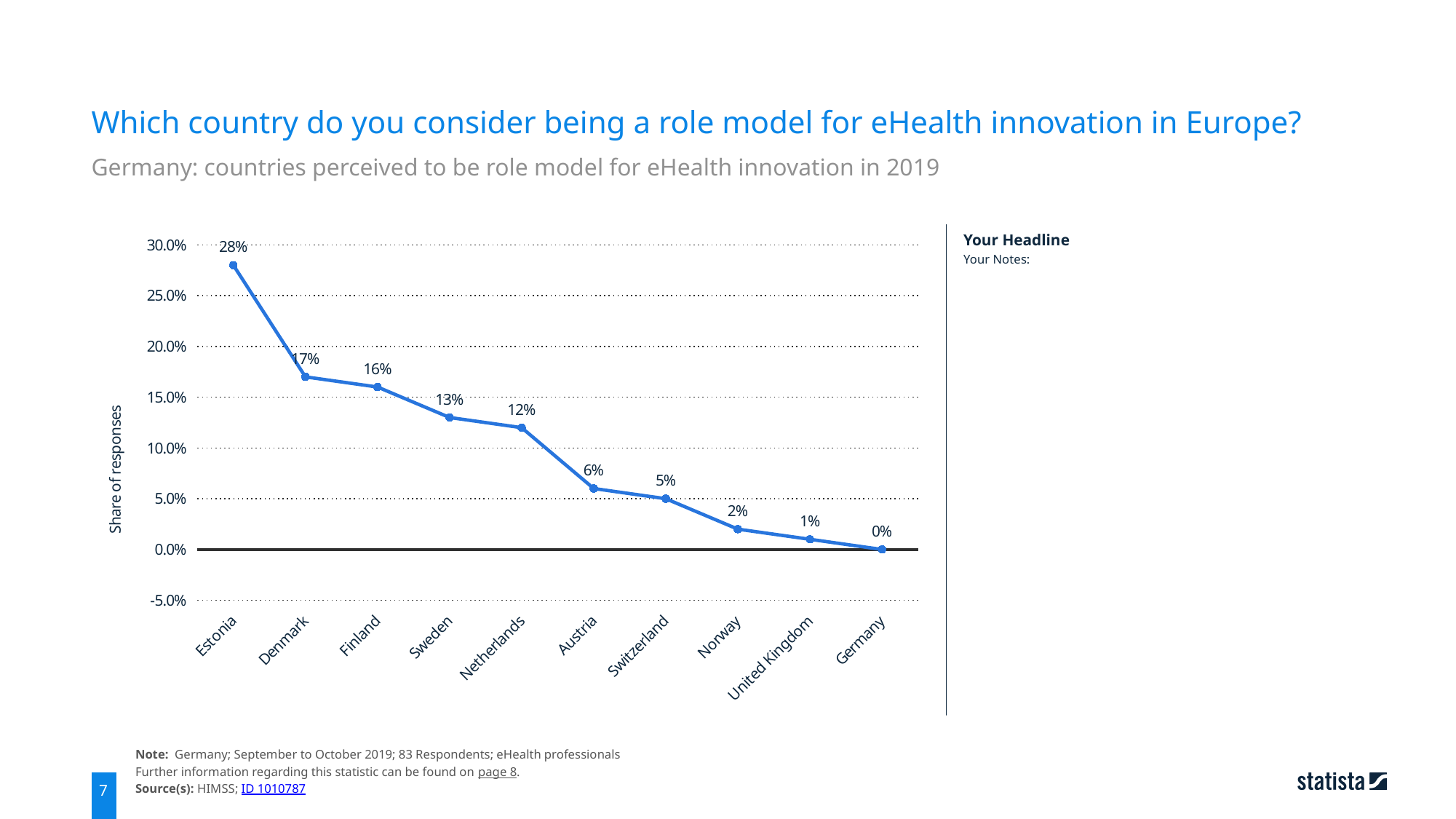
Which country has the lowest share of responses? Germany Which country has the highest share of responses? Estonia What is the difference between the values for Estonia and Denmark? 11% What kind of chart is shown on the slide? line chart What is the difference between the values for Netherlands and Austria? 6% How many countries are plotted on the chart? 10 Is the value for Denmark greater or less than 20.0%? less Do the values rise or fall from left to right along the x axis? fall What is the value shown for Sweden? 13% What share of responses is shown for Switzerland? 5% What share of responses named Estonia as a role model for eHealth innovation? 28% Which has a higher share of responses, Finland or Norway? Finland